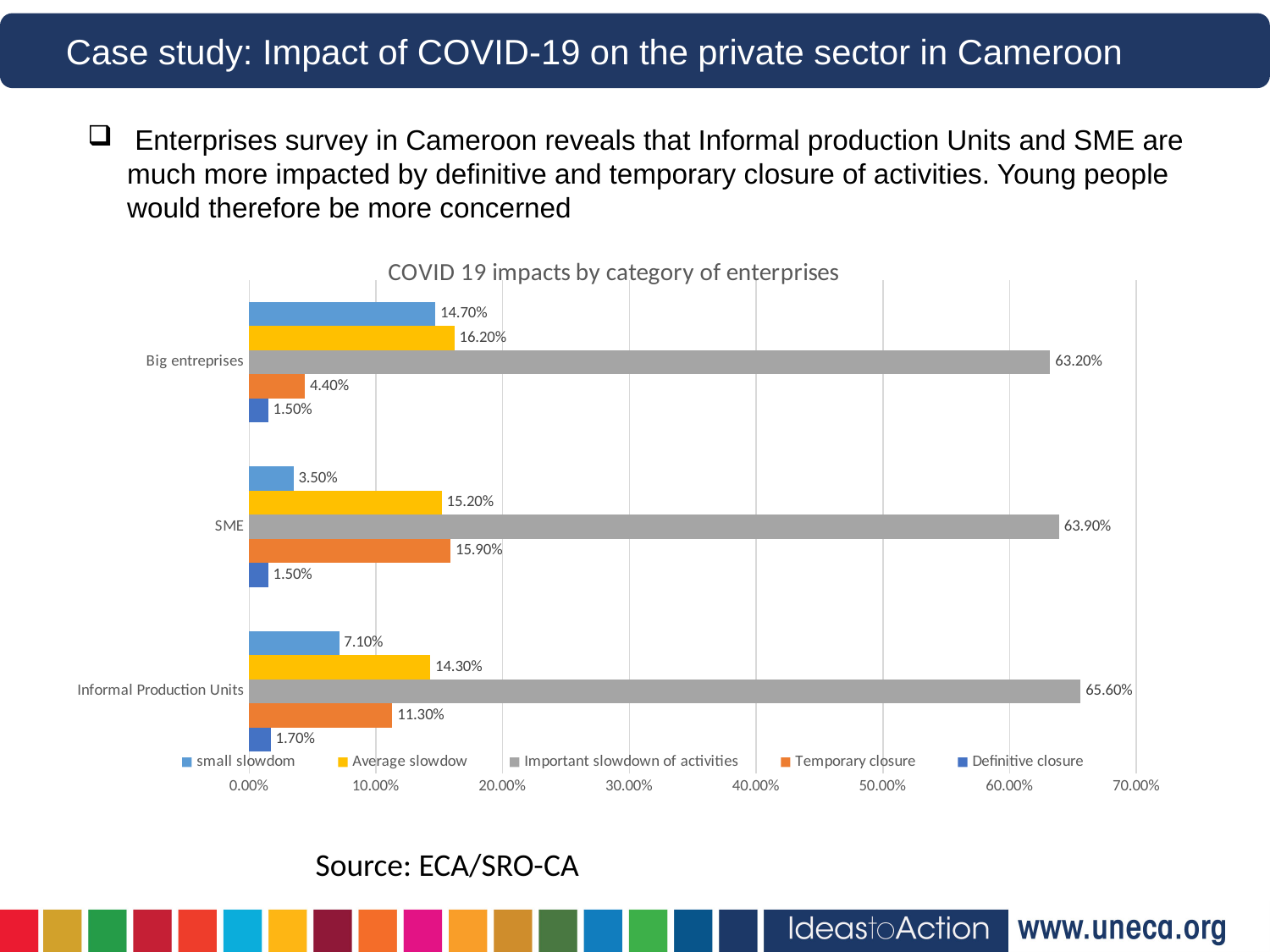
What type of chart is shown on the slide? Bar chart What is the value of small slowdom for Big entreprises? 14.70% How many series does the chart legend list? 5 Which enterprise category has the highest value for Important slowdown of activities? Informal Production Units What is the value of Temporary closure for SME? 15.90% Is the value of Important slowdown of activities for SME greater or less than 60.00%? greater How many enterprise categories are shown on the chart? 3 Which enterprise category has the lowest value for Temporary closure? Big entreprises What is the value of Important slowdown of activities for Informal Production Units? 65.60% What is the difference between Temporary closure for SME and Temporary closure for Big entreprises? 11.50% Which is larger: Average slowdow for Big entreprises or Average slowdow for Informal Production Units? Big entreprises What is the title of the chart? COVID 19 impacts by category of enterprises